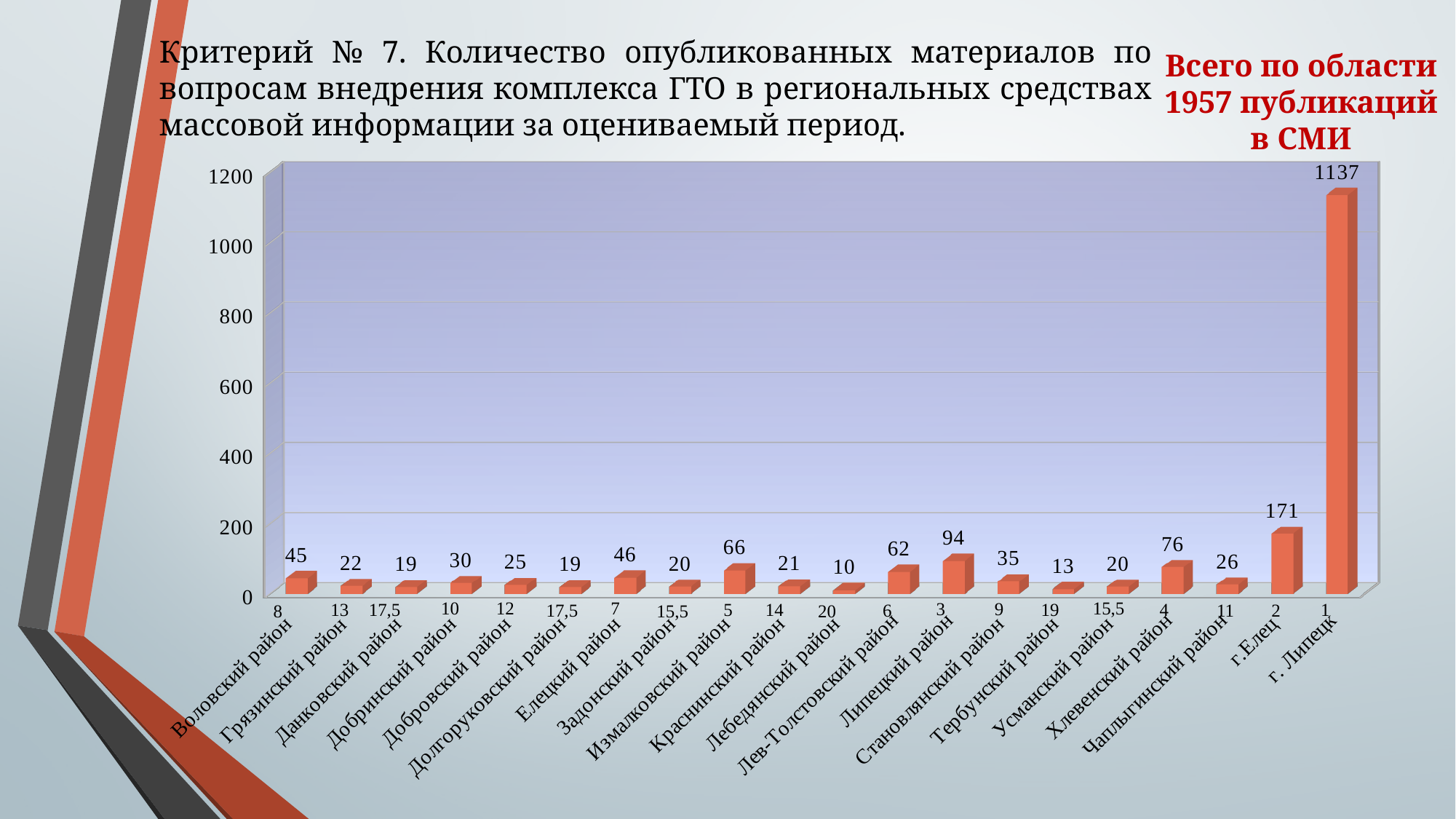
What value is shown for г. Липецк? 1137 What is the difference between the values for Измалковский район and Лев-Толстовский район? 4 What is the difference between the values for г. Липецк and г.Елец? 966 Is the value for г. Липецк greater or less than 1000? greater Which is larger, the value for Воловский район or the value for Становлянский район? Воловский район What kind of chart is this? bar chart How many categories are shown on the x axis? 20 Which category has the highest value? г. Липецк What value is shown for г.Елец? 171 What value is shown for Липецкий район? 94 What value is shown for Хлевенский район? 76 Which category has the lowest value? Лебедянский район